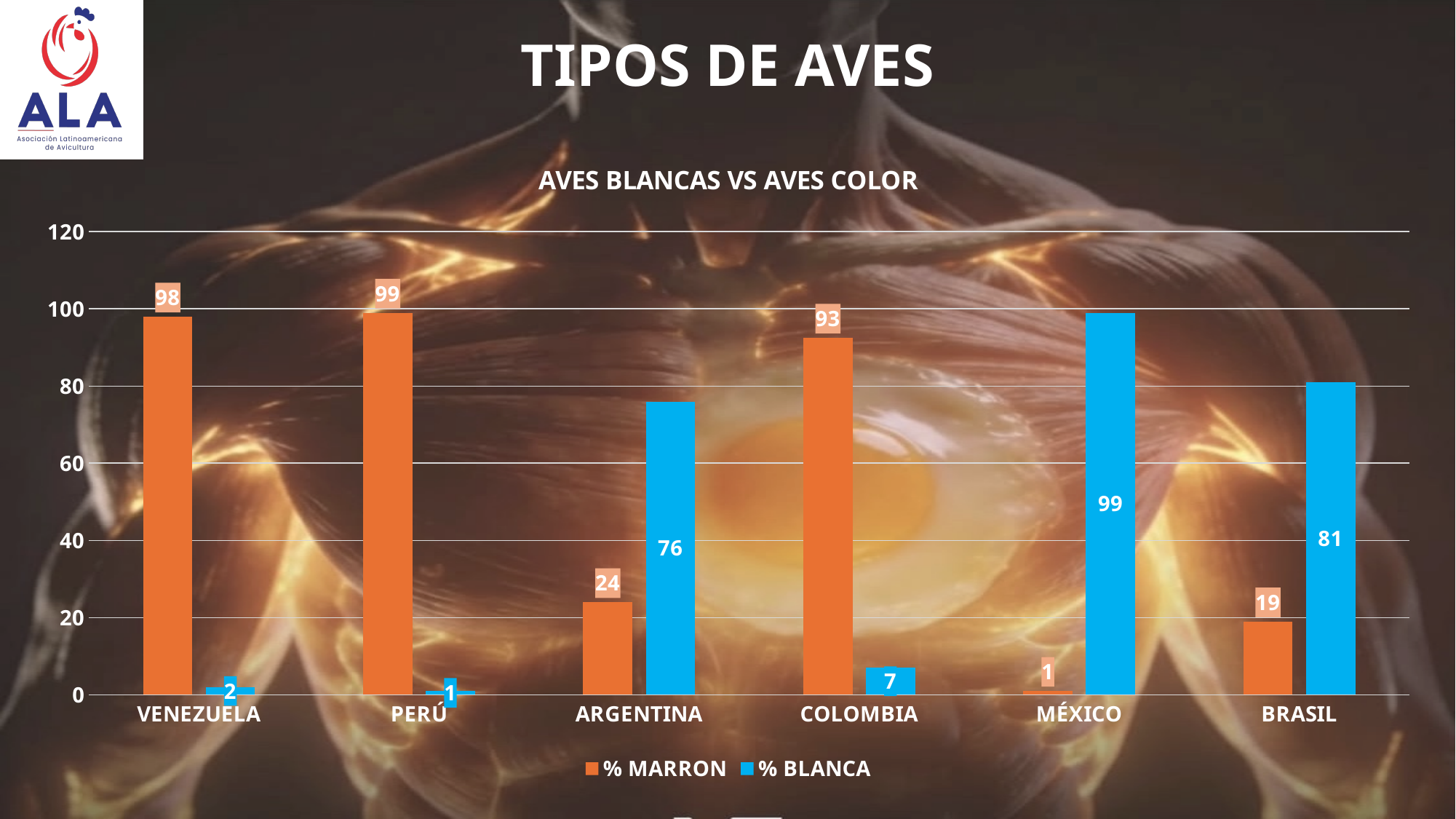
Is the % MARRON value for Venezuela greater or less than 80? greater Which country has the highest % MARRON value? Perú Which is larger for Brasil, % MARRON or % BLANCA? % BLANCA What is the % BLANCA value for Argentina? 76 What is the difference between the % BLANCA and % MARRON values for Argentina? 52 How many countries are shown on the x axis? 6 What is the % BLANCA value for Brasil? 81 What kind of chart is shown on the slide? Bar chart What is the title of the chart? AVES BLANCAS VS AVES COLOR What is the % MARRON value for Colombia? 93 How many series does the legend list? 2 Which country has the lowest % BLANCA value? Perú